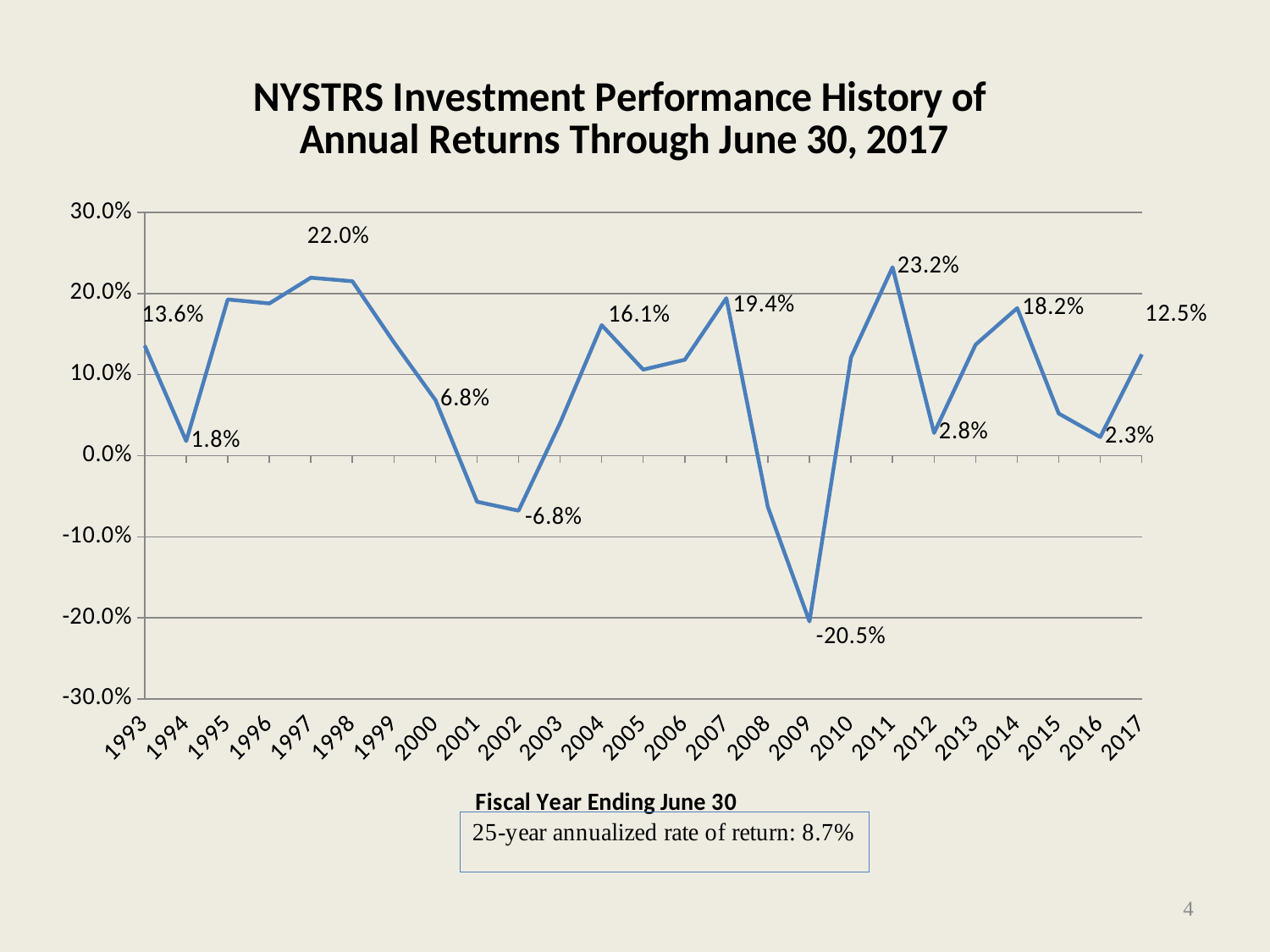
What was the annual return for fiscal year 2011? 23.2% Is the value for 2008 greater or less than 0.0%? less Is the value for 1998 greater or less than 20.0%? greater What kind of chart is shown on the slide? Line chart Which fiscal year had the highest annual return? 2011 How many fiscal years are plotted on the x axis? 25 What is the x-axis title of the chart? Fiscal Year Ending June 30 What is the difference in percentage points between the 1997 return and the 1993 return? 8.4 percentage points Which fiscal year had the lowest annual return? 2009 What was the annual return for fiscal year 2009? -20.5% What was the annual return for fiscal year 2017? 12.5% Which year had a higher annual return, 2004 or 2014? 2014